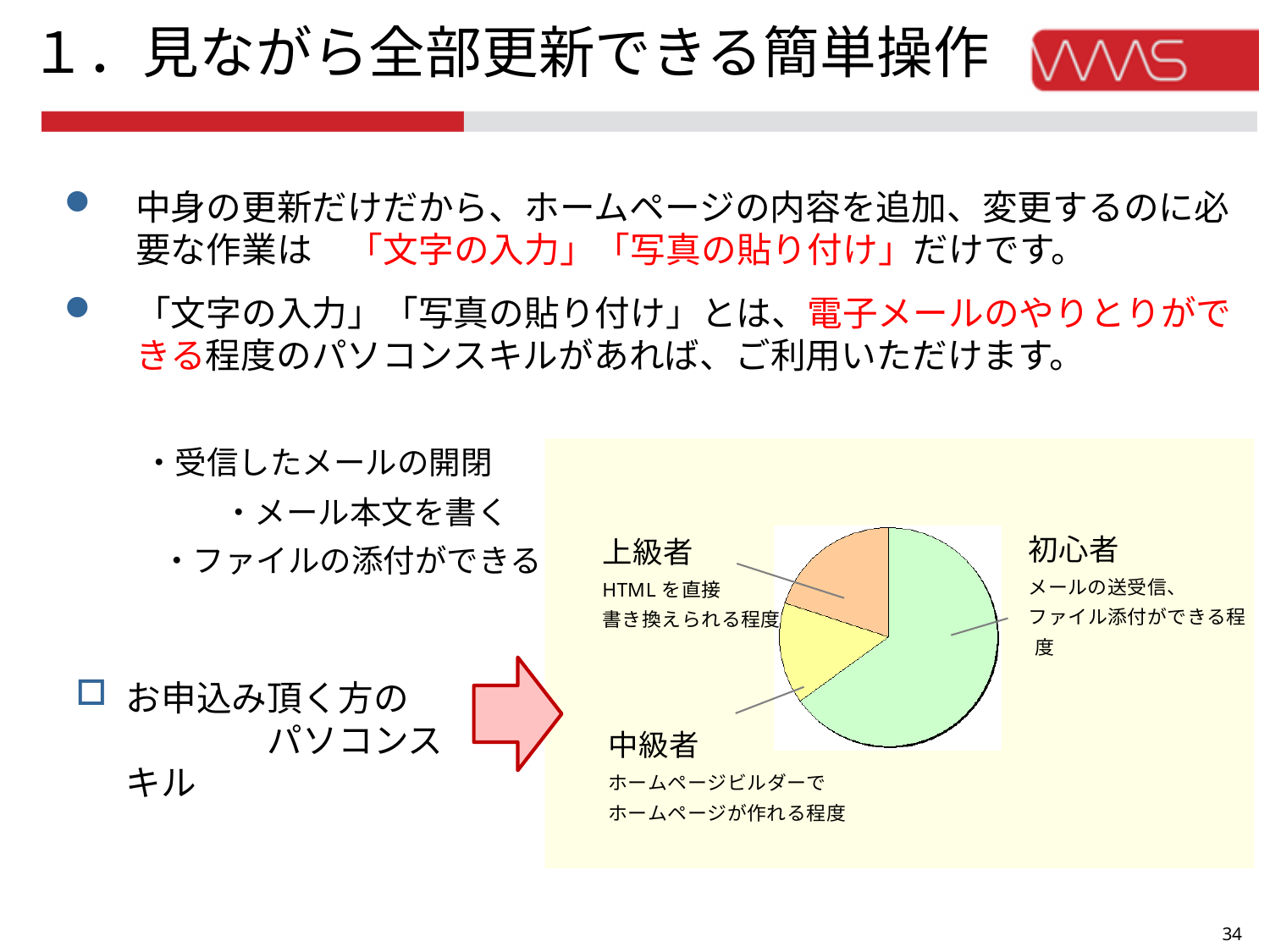
What colour is the 初心者 slice in the pie chart? green Does the 初心者 slice take up more or less than half of the pie chart? more Which slice is larger in the pie chart, 初心者 or 上級者? 初心者 Which slice is larger in the pie chart, 初心者 or 中級者? 初心者 What colour is the 上級者 slice in the pie chart? orange What kind of chart is shown on the slide? pie chart Which category has the largest slice in the pie chart? 初心者 How many slices does the pie chart have? 3